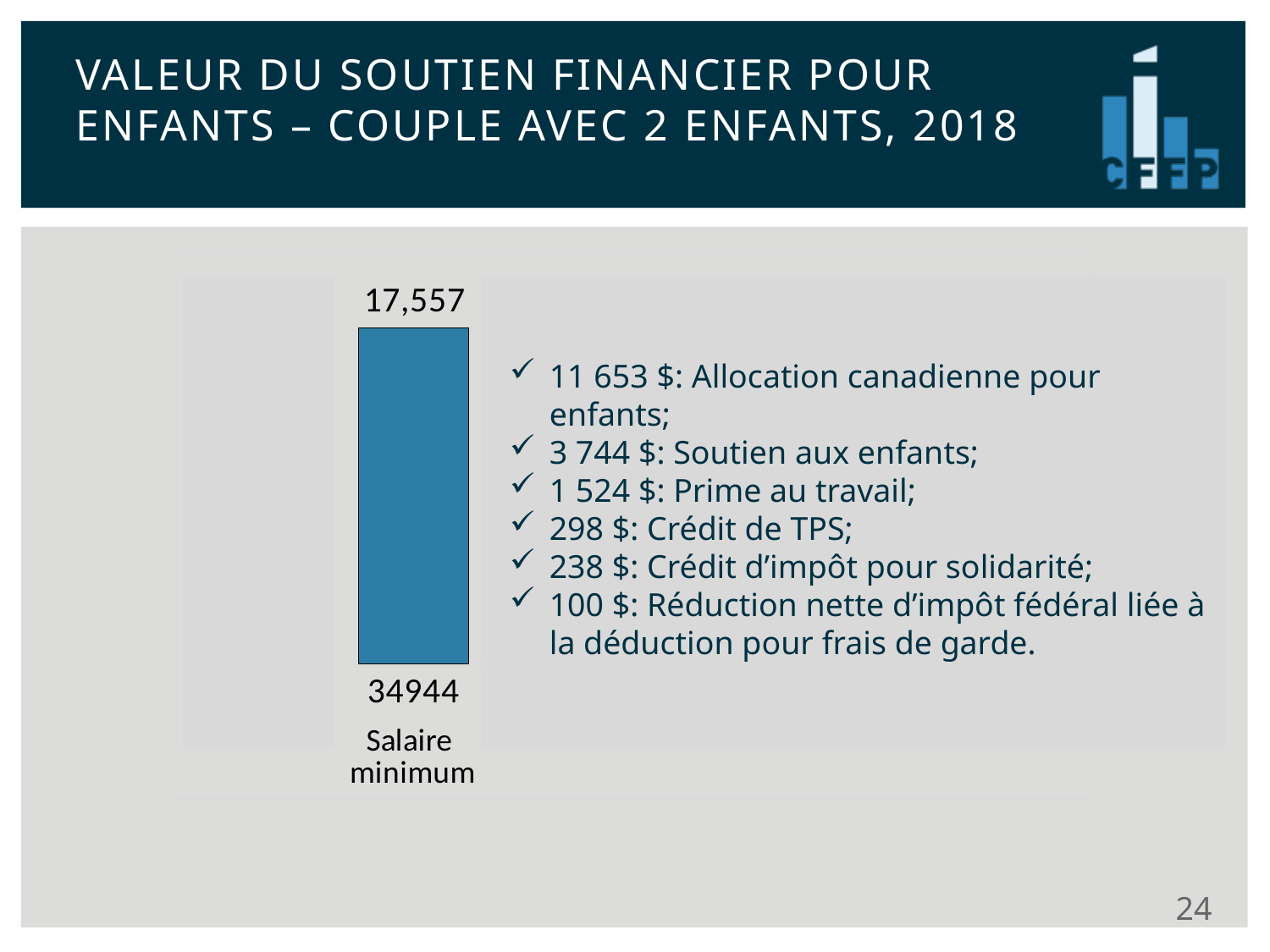
What kind of chart is shown on the slide? bar chart What number is printed directly below the bar, above the category label? 34944 What is the category label under the bar? Salaire minimum Is the value of the bar for Salaire minimum greater or less than 10,000? greater How many bars does the chart show? 1 What is the value shown on the bar for Salaire minimum? 17,557